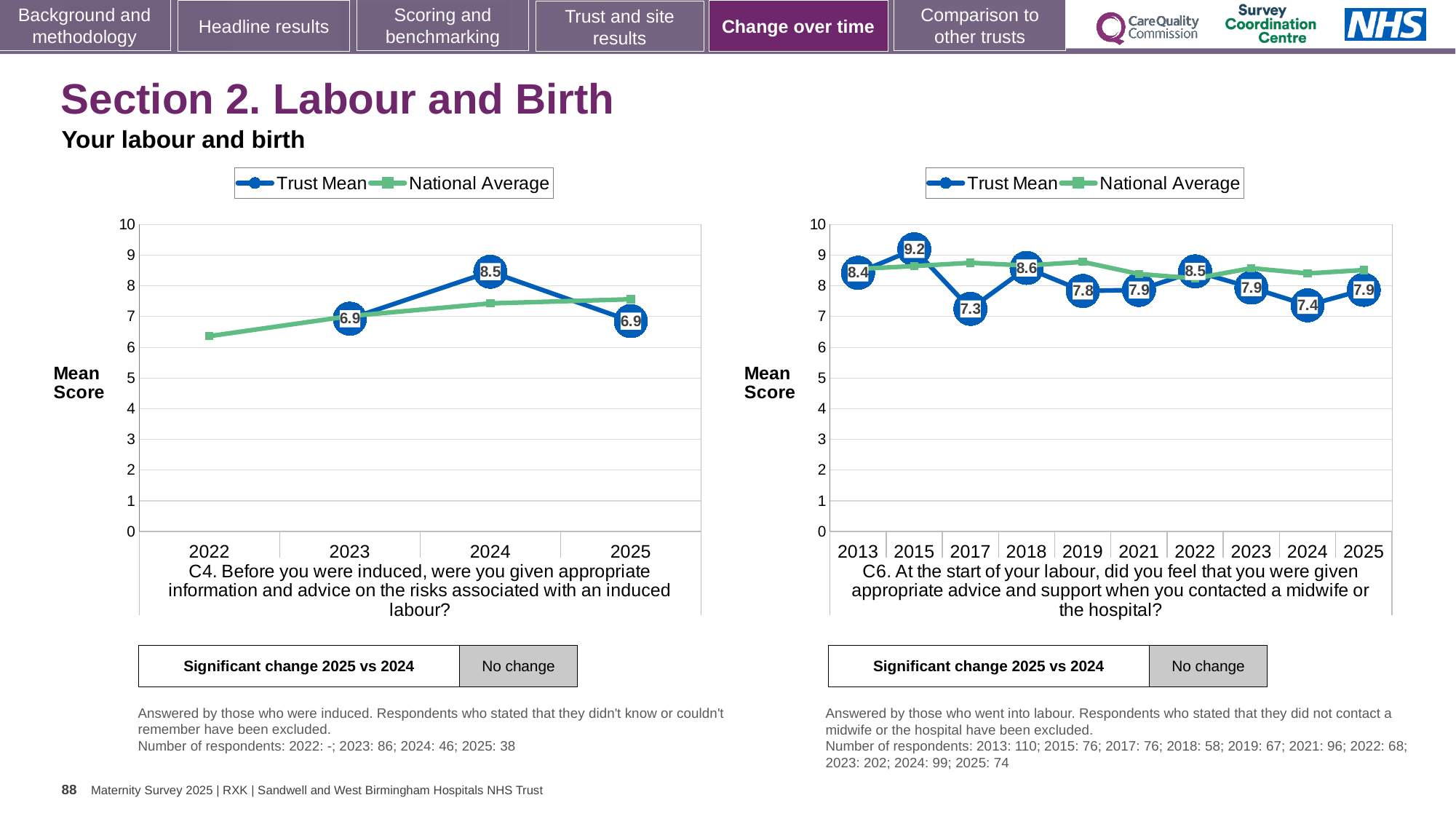
In the C6 chart on the right, what is the Trust Mean score for 2015? 9.2 In the C4 chart on the left, what is the Trust Mean score for 2025? 6.9 How many series does the legend of the C6 chart on the right list? 2 In the C6 chart on the right, which year has the lowest Trust Mean score? 2017 In the C6 chart on the right, how many years are shown on the x axis? 10 In the C6 chart on the right, what is the Trust Mean score for 2024? 7.4 In the C4 chart on the left, which year has the highest Trust Mean score? 2024 In the C4 chart on the left, what is the difference between the Trust Mean scores for 2024 and 2023? 1.6 In the C6 chart on the right, which is larger: the Trust Mean for 2018 or for 2019? 2018 In the C4 chart on the left, is the National Average for 2022 greater or less than 7? less In the C4 chart on the left, what is the Trust Mean score for 2024? 8.5 What type of chart is the C4 chart on the left? Line chart